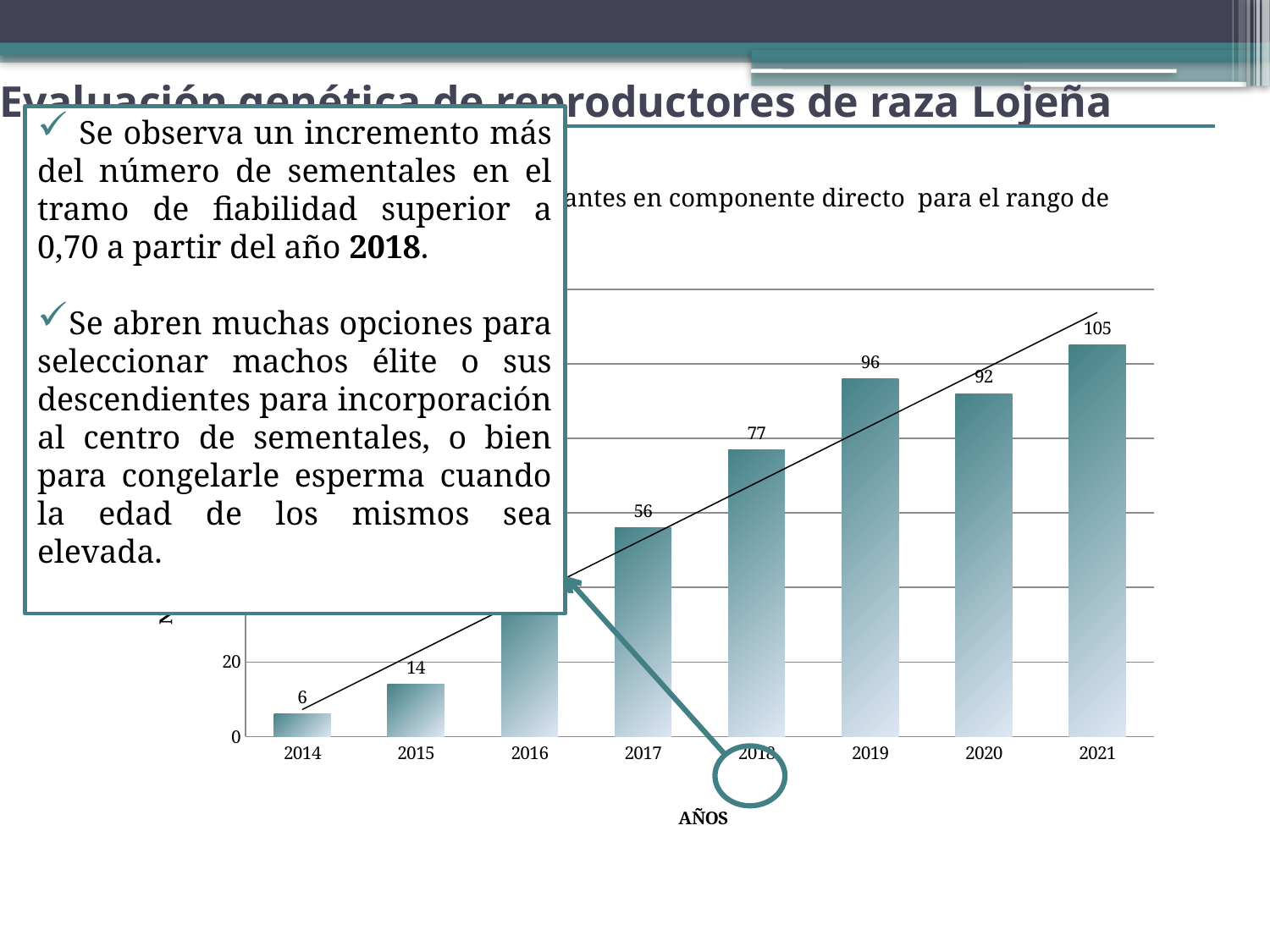
What is the value for 2017? 56 Which is larger, the value for 2019 or the value for 2020? 2019 Which year has the lowest value? 2014 Which year has the highest value? 2021 Is the value for 2016 greater or less than 20? greater What is the difference between the values for 2021 and 2020? 13 What is the value for 2018? 77 What is the value for 2014? 6 What is the value for 2020? 92 What is the value for 2015? 14 What kind of chart is shown? bar chart How many years are shown on the x axis? 8